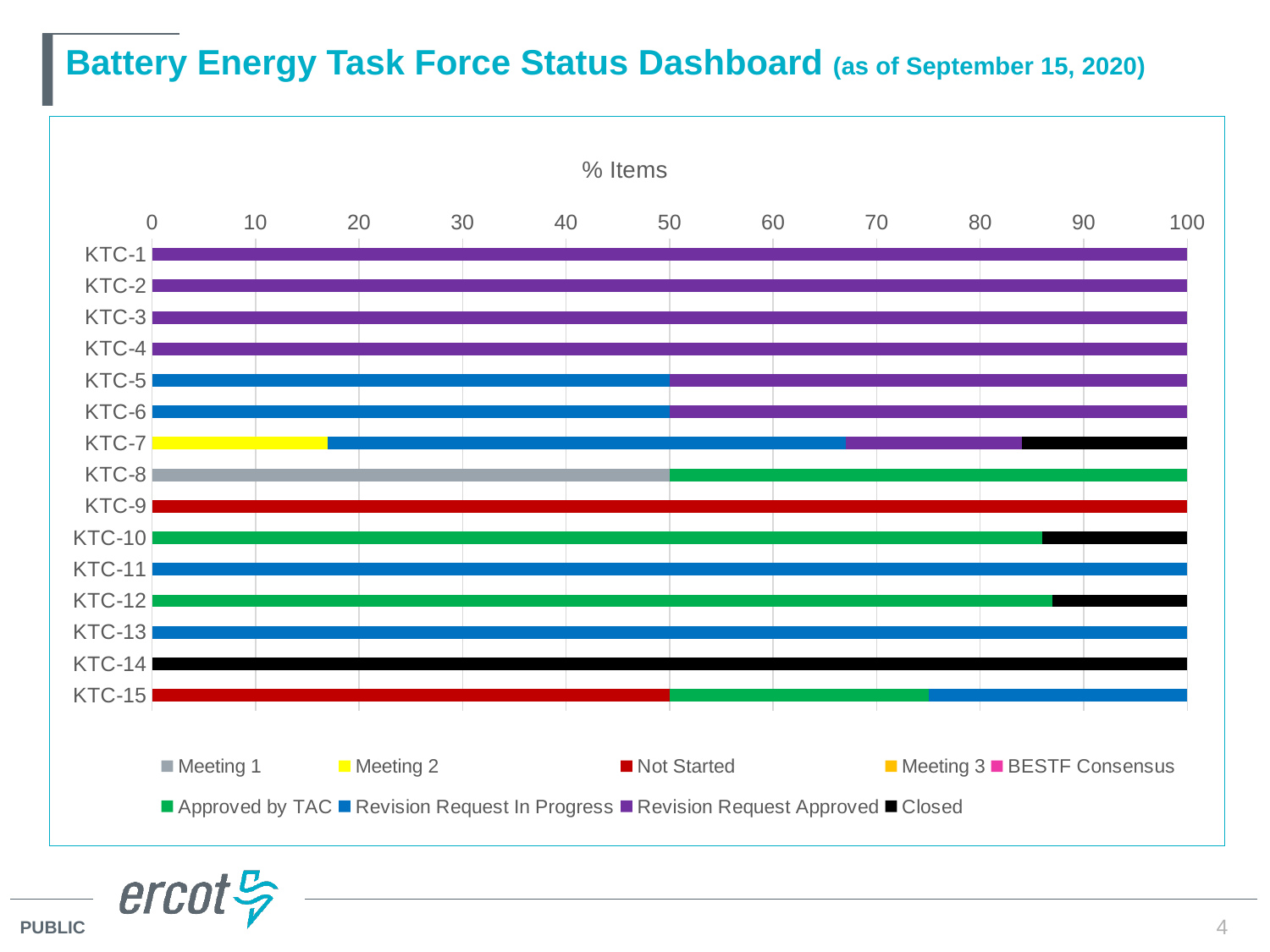
What kind of chart is shown on the slide? Stacked bar chart Is the Meeting 2 value for KTC-7 greater or less than 20? less How many series does the legend list? 9 Is the Approved by TAC value for KTC-10 greater or less than 80? greater How many KTC categories are plotted on the chart? 15 What is the total of the stacked bar for KTC-6? 100 What is the Revision Request In Progress value for KTC-5? 50 What is the Not Started value for KTC-15? 50 What is the Closed value for KTC-14? 100 What is the Not Started value for KTC-9? 100 What is the title of the chart? % Items What is the Meeting 1 value for KTC-8? 50